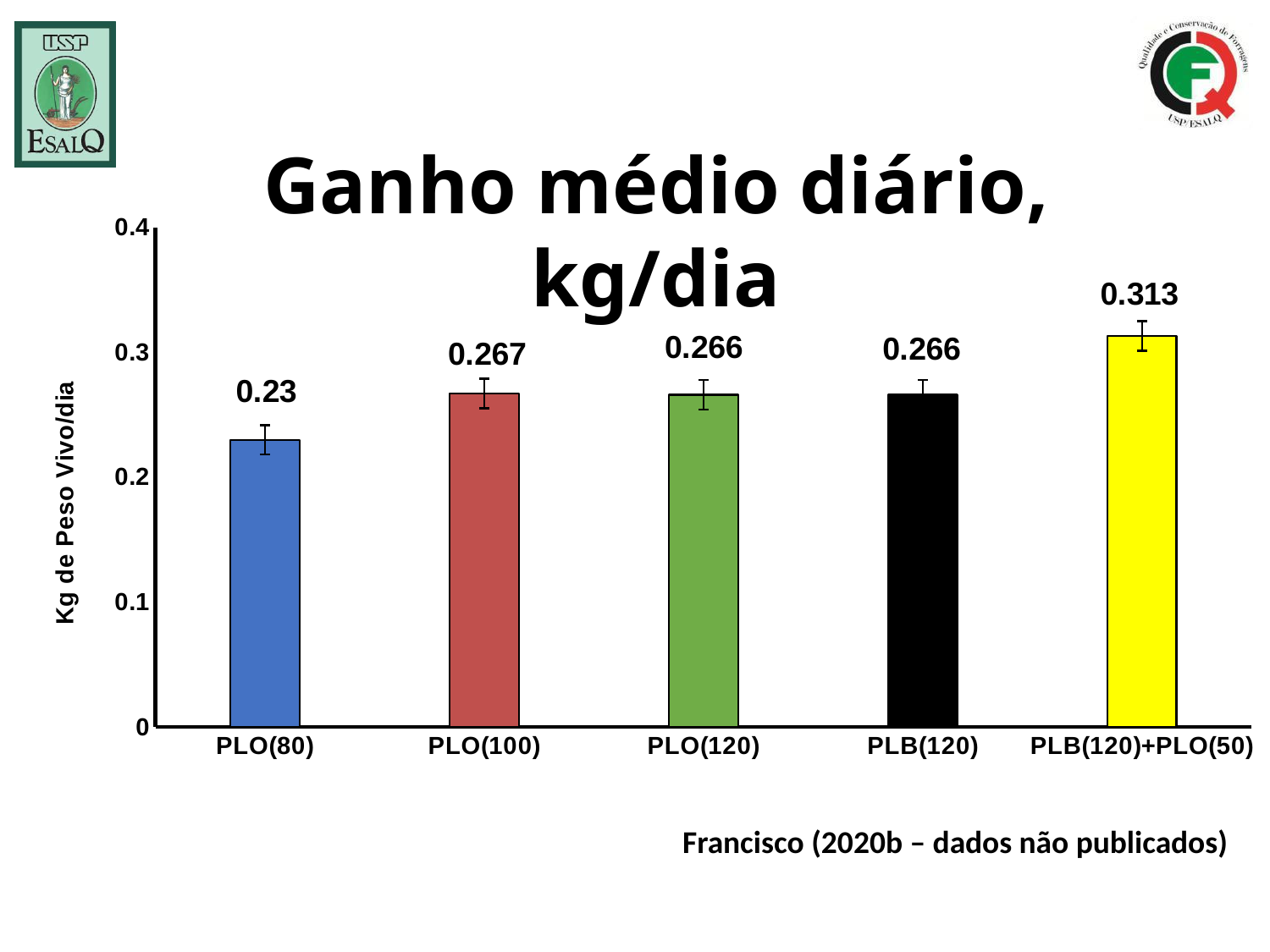
What is the value for PLO(100)? 0.267 What is the difference between the values for PLO(100) and PLO(120)? 0.001 What is the difference between the values for PLB(120)+PLO(50) and PLO(80)? 0.083 Which category has the highest value? PLB(120)+PLO(50) What kind of chart is shown? bar chart Is the value for PLB(120)+PLO(50) greater or less than 0.3? greater What is the value for PLB(120)+PLO(50)? 0.313 What is the label of the y axis? Kg de Peso Vivo/dia Which is larger, the value for PLO(80) or the value for PLB(120)? PLB(120) How many categories are shown on the x axis? 5 Which category has the lowest value? PLO(80) What is the value for PLO(80)? 0.23